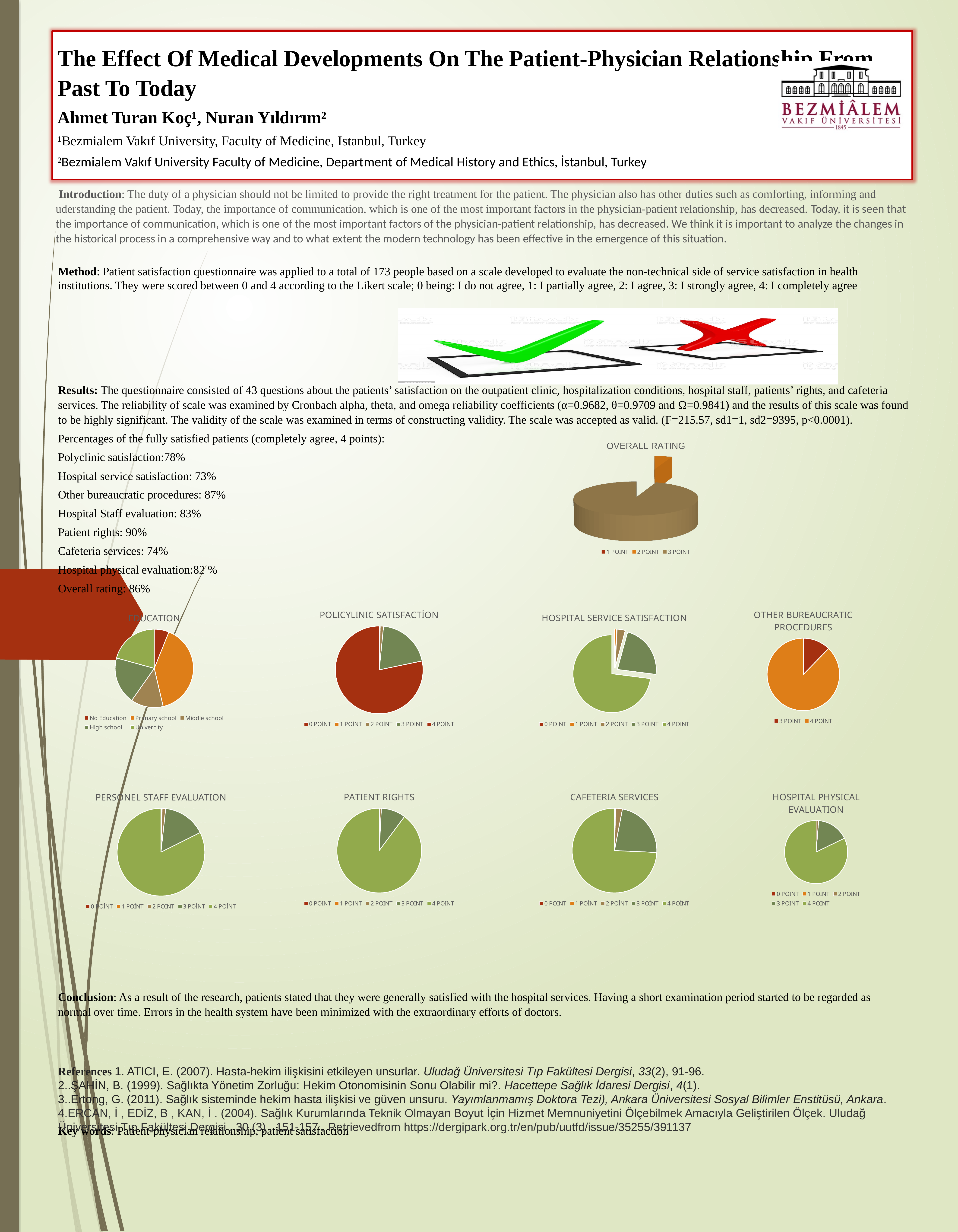
What kind of chart is the OVERALL RATING chart? pie chart In the OVERALL RATING chart, which category has the largest slice? 3 POINT How many entries does the legend of the OVERALL RATING chart list? 3 In the EDUCATION chart, which category has the largest slice? Primary school In the PATIENT RIGHTS chart, which category has the largest slice? 4 POINT In the CAFETERIA SERVICES chart, which slice is larger: 3 POİNT or 4 POİNT? 4 POİNT How many entries does the legend of the PERSONEL STAFF EVALUATION chart list? 5 What is the title of the pie chart in the bottom-right corner of the slide? HOSPITAL PHYSICAL EVALUATION How many entries does the legend of the OTHER BUREAUCRATIC PROCEDURES chart list? 2 How many categories does the legend of the EDUCATION chart list? 5